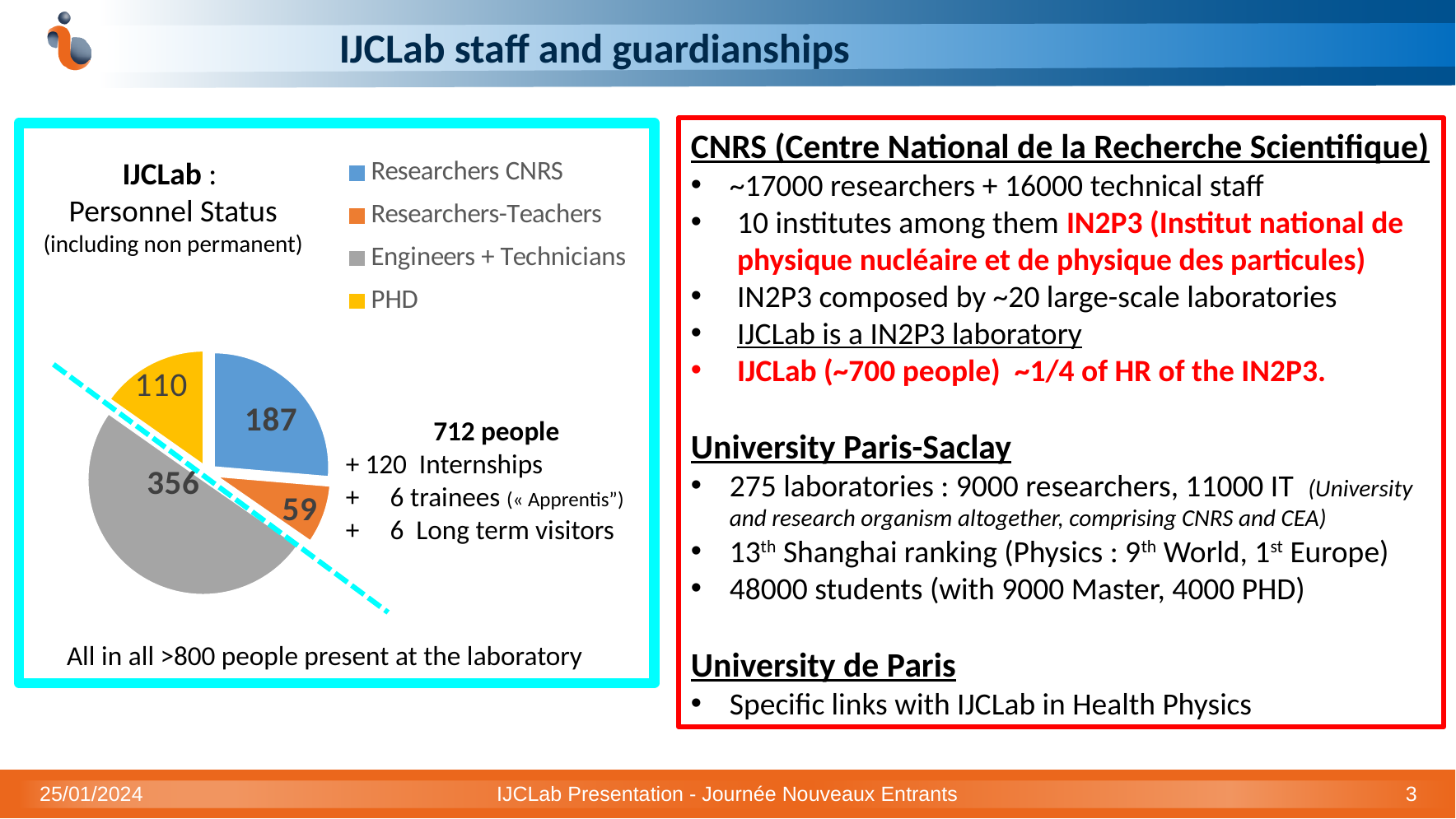
Which category has the smallest slice in the pie chart? Researchers-Teachers Which category has the largest slice in the pie chart? Engineers + Technicians What is the value for Researchers-Teachers in the pie chart? 59 What is the value for PHD in the pie chart? 110 What kind of chart is shown on the slide? pie chart What is the value for Engineers + Technicians in the pie chart? 356 Which is larger in the pie chart, PHD or Researchers-Teachers? PHD How many slices does the pie chart have? 4 What is the difference between the Engineers + Technicians value and the Researchers CNRS value? 169 What is the value for Researchers CNRS in the pie chart? 187 How many entries does the legend of the pie chart list? 4 What colour is the Engineers + Technicians slice in the pie chart? grey